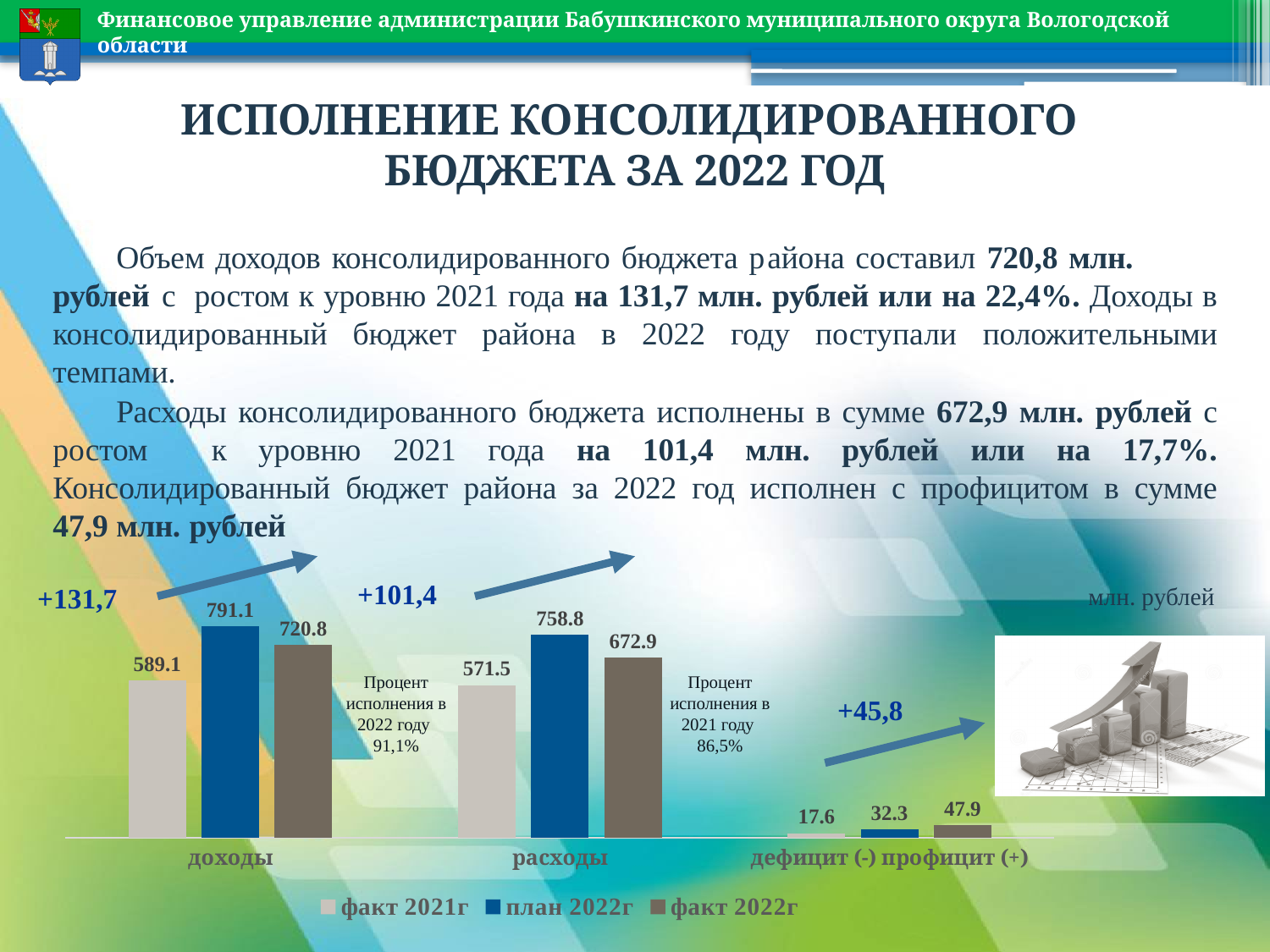
What is the value of 'план 2022г' for 'расходы'? 758.8 What unit is indicated for the values in the chart? млн. рублей What type of chart is shown on the slide? bar chart Which category has the lowest 'факт 2021г' value? дефицит (-) профицит (+) What is the value of 'факт 2021г' for 'дефицит (-) профицит (+)'? 17.6 Which category has the highest 'план 2022г' value? доходы Which is larger for 'расходы': 'факт 2021г' or 'факт 2022г'? факт 2022г What is the value of 'факт 2022г' for 'доходы'? 720.8 What is the difference between 'план 2022г' and 'факт 2022г' for 'доходы'? 70.3 How many series does the chart legend list? 3 How many categories are shown on the x axis of the chart? 3 What is the difference between 'факт 2022г' and 'факт 2021г' for 'дефицит (-) профицит (+)'? 30.3